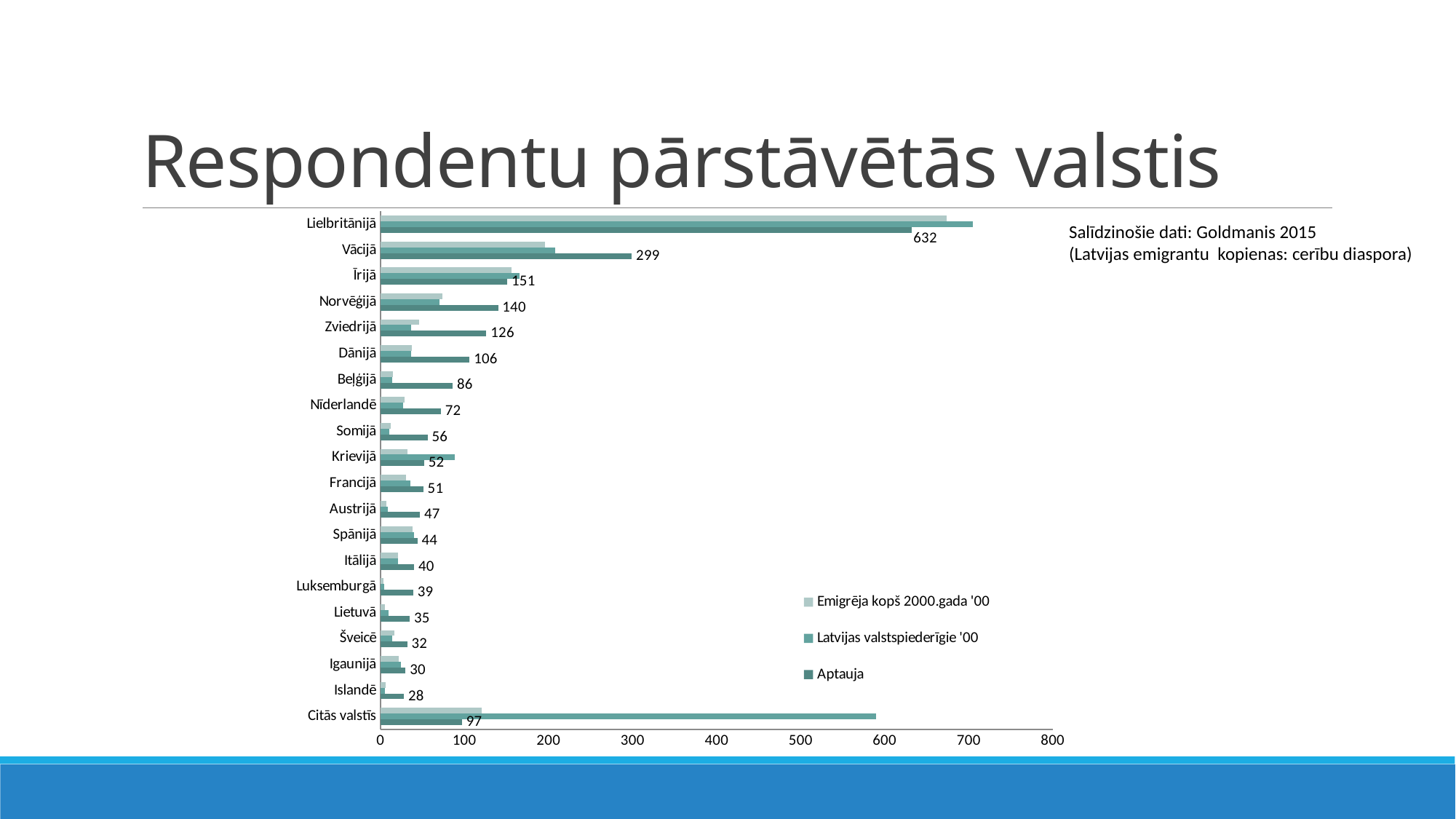
Which has a larger Aptauja value, Norvēģijā or Zviedrijā? Norvēģijā Which country has the highest Aptauja value? Lielbritānijā What is the Aptauja value for Lielbritānijā? 632 What is the difference between the Aptauja values for Lielbritānijā and Vācijā? 333 What is the Aptauja value for Dānijā? 106 How many countries/categories are shown on the chart? 20 Which category has the lowest Aptauja value? Islandē Is the Emigrēja kopš 2000.gada '00 value for Lielbritānijā greater or less than 600? greater What is the Aptauja value for Citās valstīs? 97 What type of chart is shown on the slide? Bar chart What is the Aptauja value for Vācijā? 299 How many series does the legend list? 3